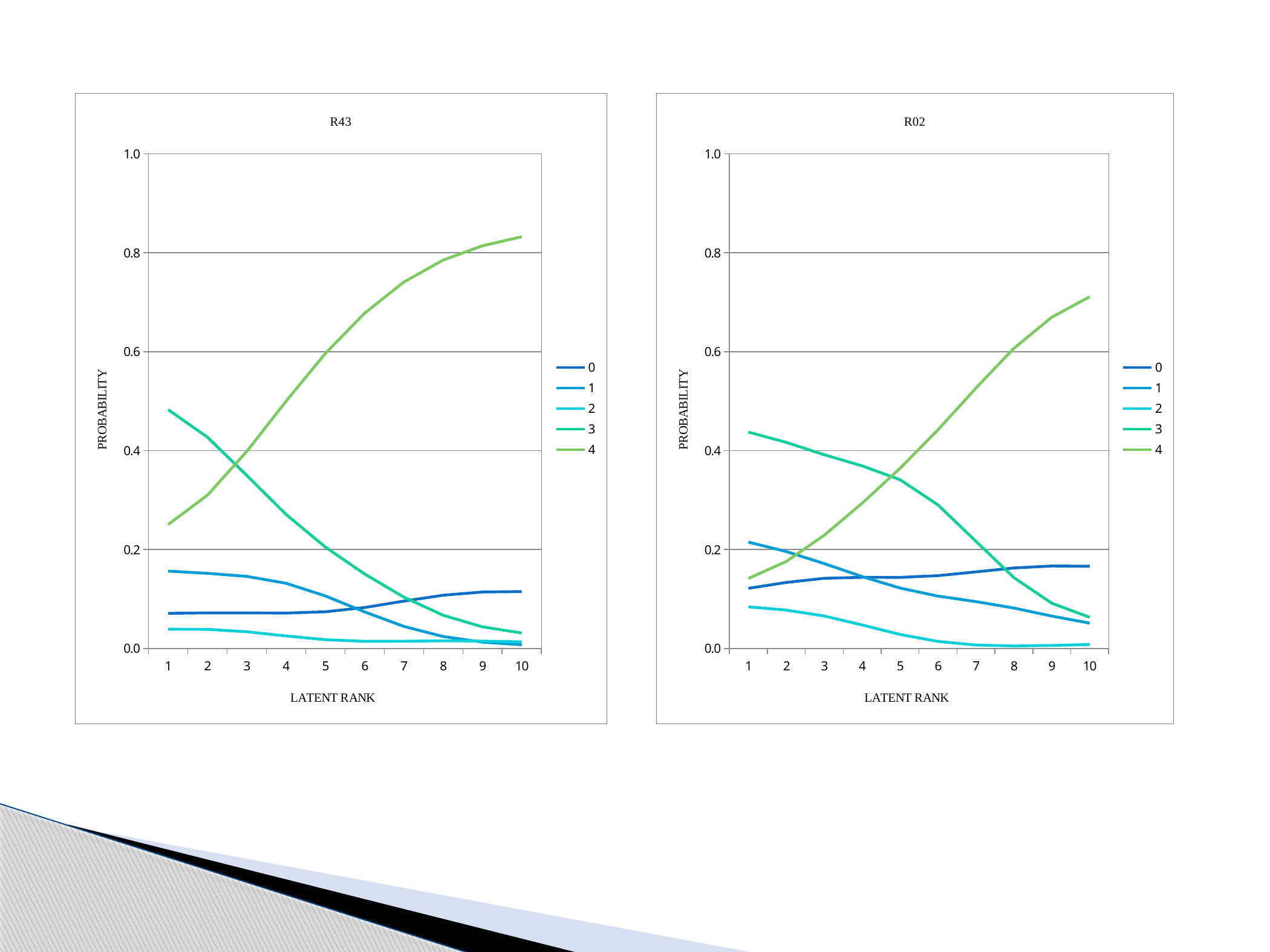
How many latent rank values are shown on the x axis of the R43 chart? 10 In the R43 chart, is the value for series 4 at latent rank 10 greater or less than 0.8? greater In the R02 chart, which is larger at latent rank 10: the value for series 0 or the value for series 1? series 0 How many series does the legend of the R02 chart list? 5 In the R43 chart, which series has the highest value at latent rank 1? 3 In the R43 chart, is the value for series 3 at latent rank 1 greater or less than 0.4? greater In the R02 chart, is the value for series 4 at latent rank 10 greater or less than 0.8? less What is the label of the y axis on the R02 chart? PROBABILITY In the R43 chart, does the value for series 4 rise or fall as latent rank increases? rise What kind of chart is the R43 chart? line chart In the R43 chart, does the value for series 3 rise or fall as latent rank increases? fall